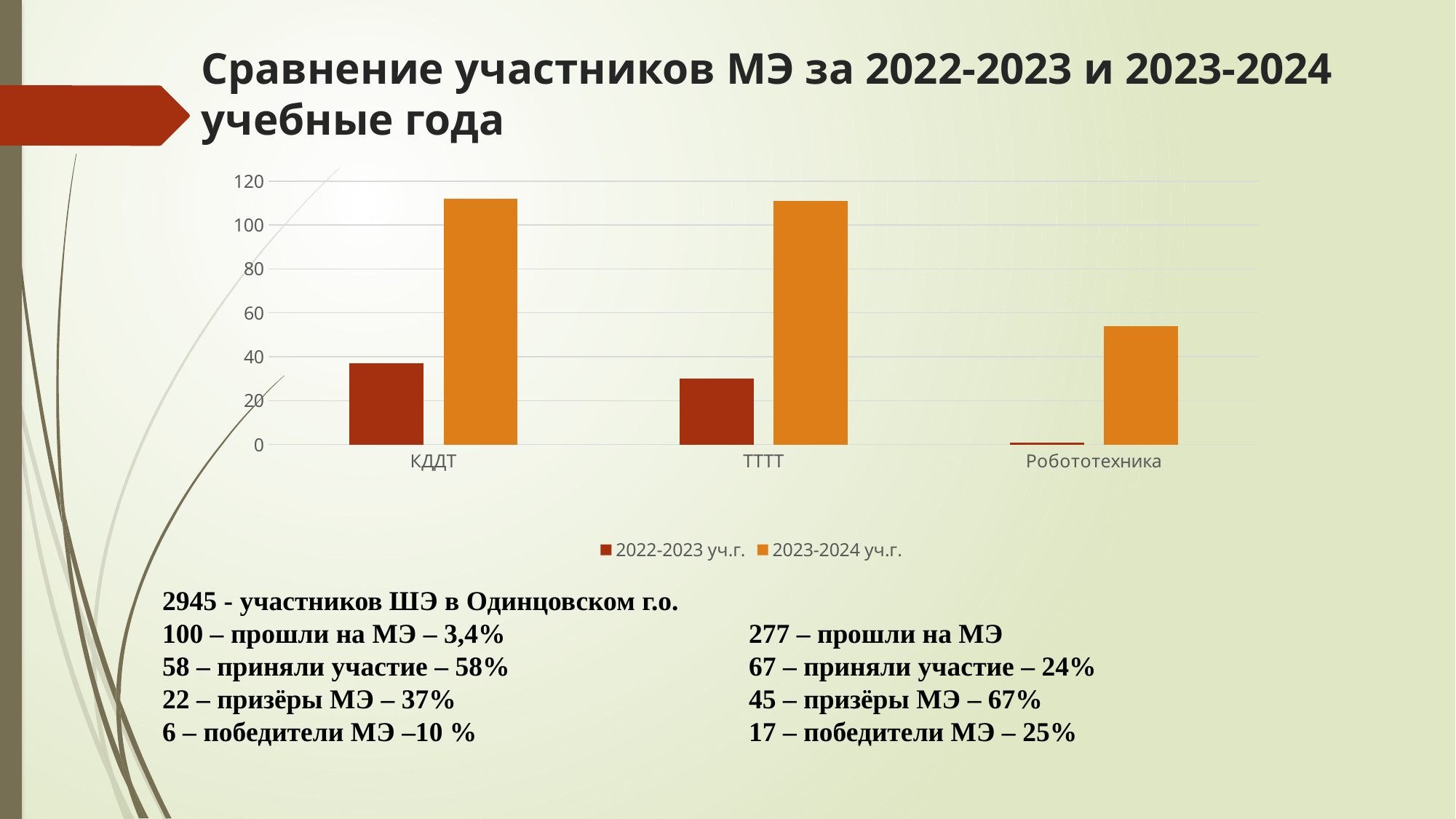
Is the value for ТТТТ in the 2023-2024 уч.г. series greater or less than 100? greater Which category has the lowest value for the 2023-2024 уч.г. series? Робототехника Is the value for Робототехника in the 2023-2024 уч.г. series greater or less than 40? greater Is the value for КДДТ in the 2023-2024 уч.г. series greater or less than 100? greater Which category has the highest value for the 2022-2023 уч.г. series? КДДТ What kind of chart is shown on the slide? bar chart For КДДТ, which series has the larger value: 2022-2023 уч.г. or 2023-2024 уч.г.? 2023-2024 уч.г. Which colour represents the 2023-2024 уч.г. series in the chart? orange Which category has the lowest value for the 2022-2023 уч.г. series? Робототехника How many series does the chart legend list? 2 How many categories are shown on the x axis of the chart? 3